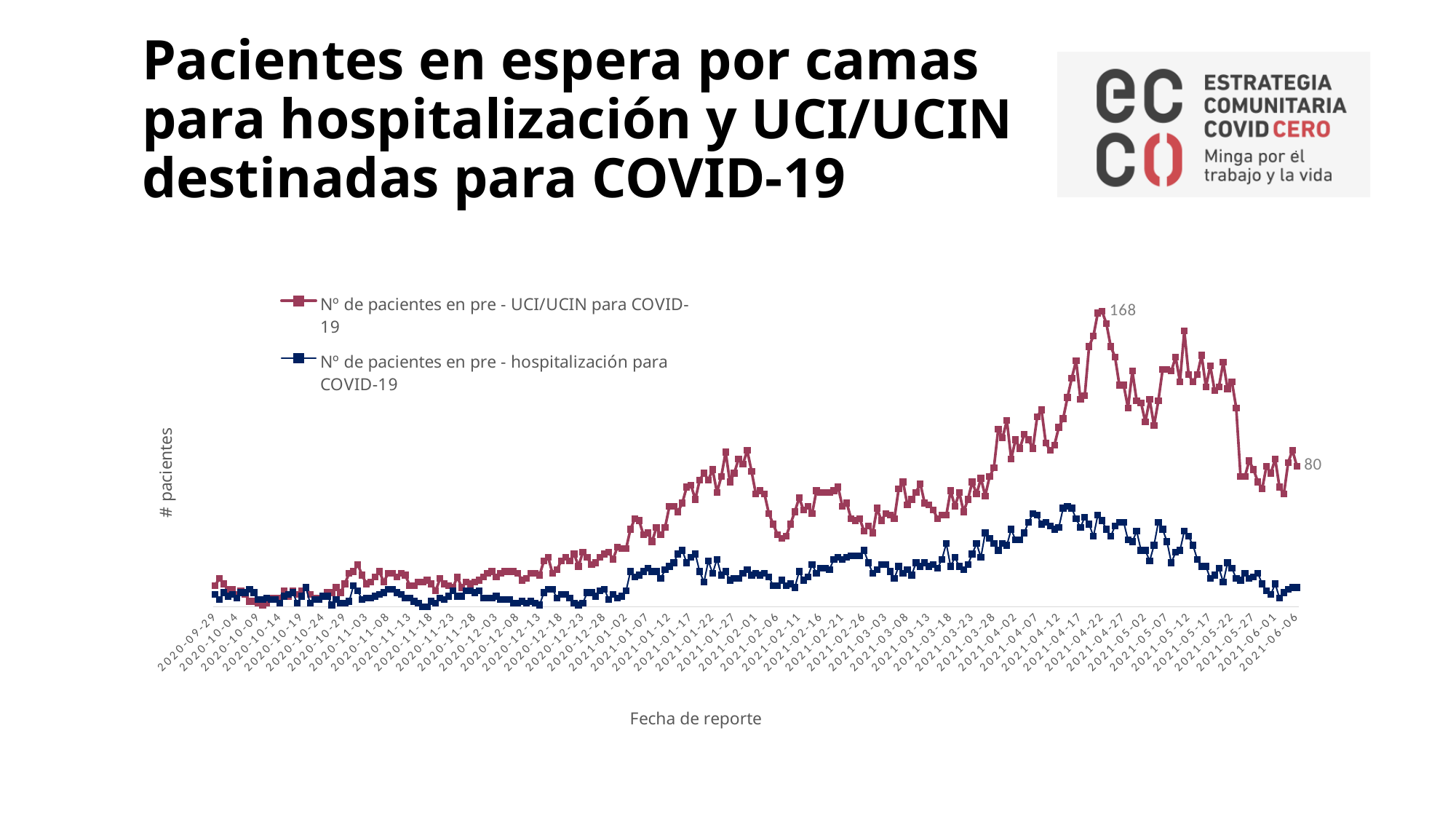
What is the label of the y axis? # pacientes How many series does the legend list? 2 Does the UCI/UCIN series rise or fall between its peak of 168 and its final value of 80? fall What is the difference between the peak value (168) and the final value (80) of the UCI/UCIN series? 88 What kind of chart is shown on the slide? line chart Overall, does the hospitalización series rise or fall from 2020-09-29 to 2021-04-17? rise What is the highest labelled value of the 'Nº de pacientes en pre - UCI/UCIN para COVID-19' series? 168 What is the last labelled value of the 'Nº de pacientes en pre - UCI/UCIN para COVID-19' series, at 2021-06-06? 80 Which series reaches the higher peak: UCI/UCIN or hospitalización? Nº de pacientes en pre - UCI/UCIN para COVID-19 Around 2021-04-22, which series has the larger value: UCI/UCIN or hospitalización? Nº de pacientes en pre - UCI/UCIN para COVID-19 What is the label of the x axis? Fecha de reporte